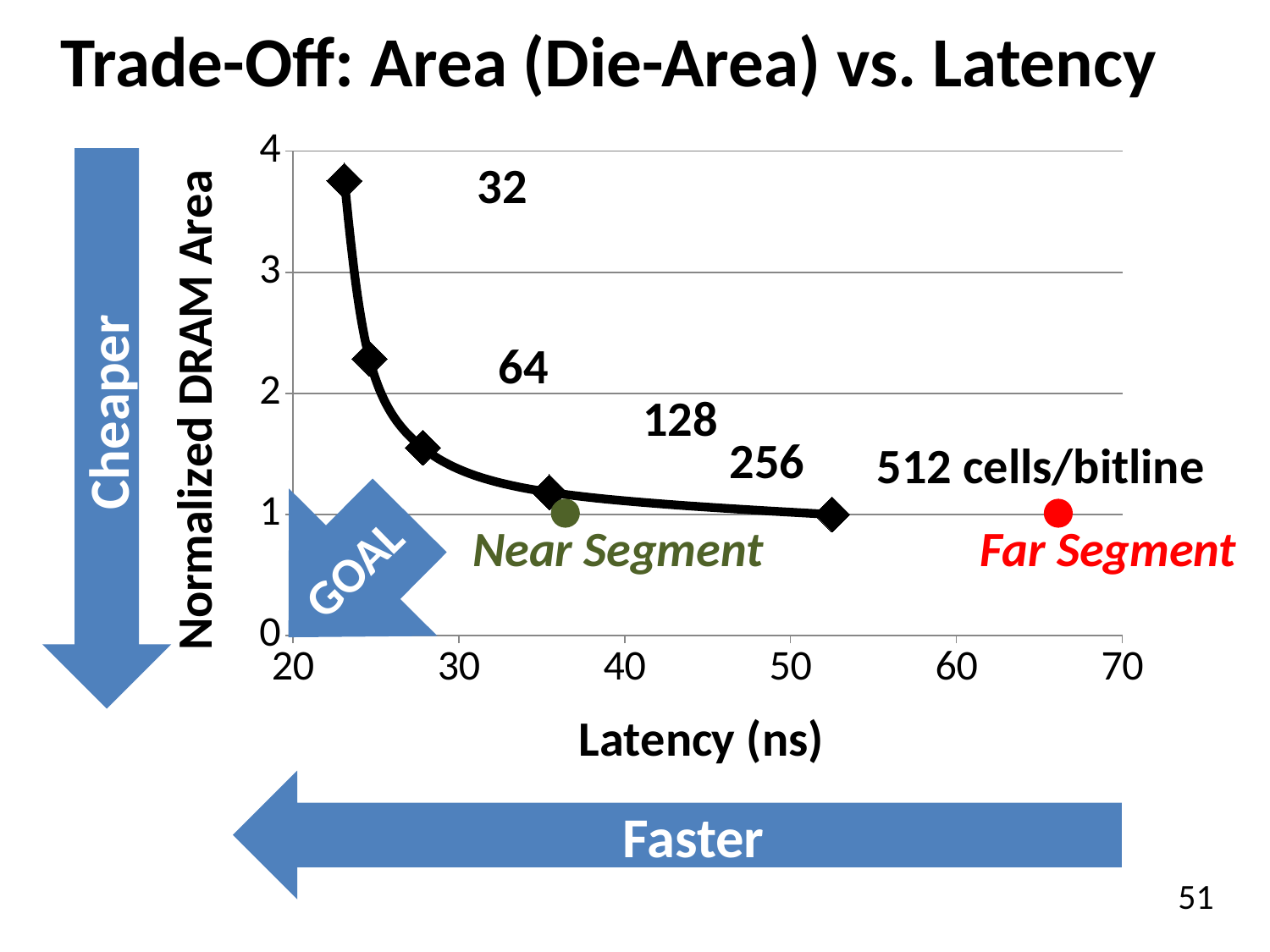
What is the title of the slide's chart? Trade-Off: Area (Die-Area) vs. Latency How many black diamond data points are plotted on the curve? 5 As latency increases along the x axis, does the Normalized DRAM Area rise or fall? fall Which cells/bitline configuration has the lowest Normalized DRAM Area? 512 Is the Normalized DRAM Area for 32 cells/bitline greater or less than 3? greater Is the latency of the Far Segment point greater or less than 60 ns? greater Which cells/bitline configuration has the highest Normalized DRAM Area? 32 Which has a higher Normalized DRAM Area, 64 cells/bitline or 256 cells/bitline? 64 cells/bitline Is the Normalized DRAM Area for 64 cells/bitline greater or less than 2? greater What is the label of the x axis? Latency (ns)